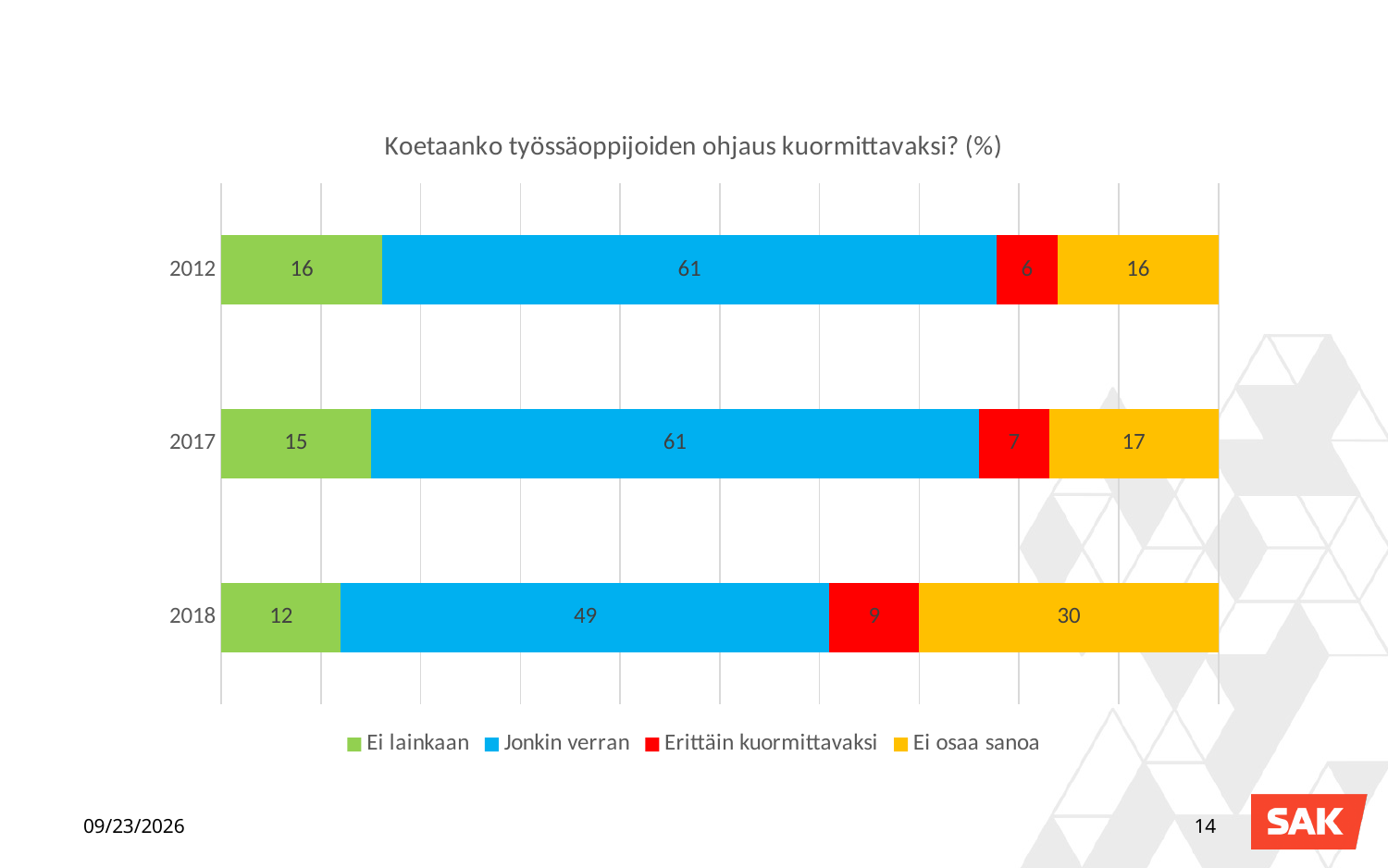
What kind of chart is shown on the slide? Stacked bar chart What is the total of the stacked bar for 2018? 100 What is the difference between the "Jonkin verran" values for 2017 and 2018? 12 Which year has the highest value for "Ei osaa sanoa"? 2018 How many series does the legend list? 4 How many years are shown on the chart? 3 What is the value for "Ei osaa sanoa" in 2012? 16 Is the "Erittäin kuormittavaksi" value larger in 2012 or in 2018? 2018 What is the title of the chart? Koetaanko työssäoppijoiden ohjaus kuormittavaksi? (%) What is the value for "Jonkin verran" in 2018? 49 What is the value for "Erittäin kuormittavaksi" in 2017? 7 Which year has the lowest value for "Ei lainkaan"? 2018